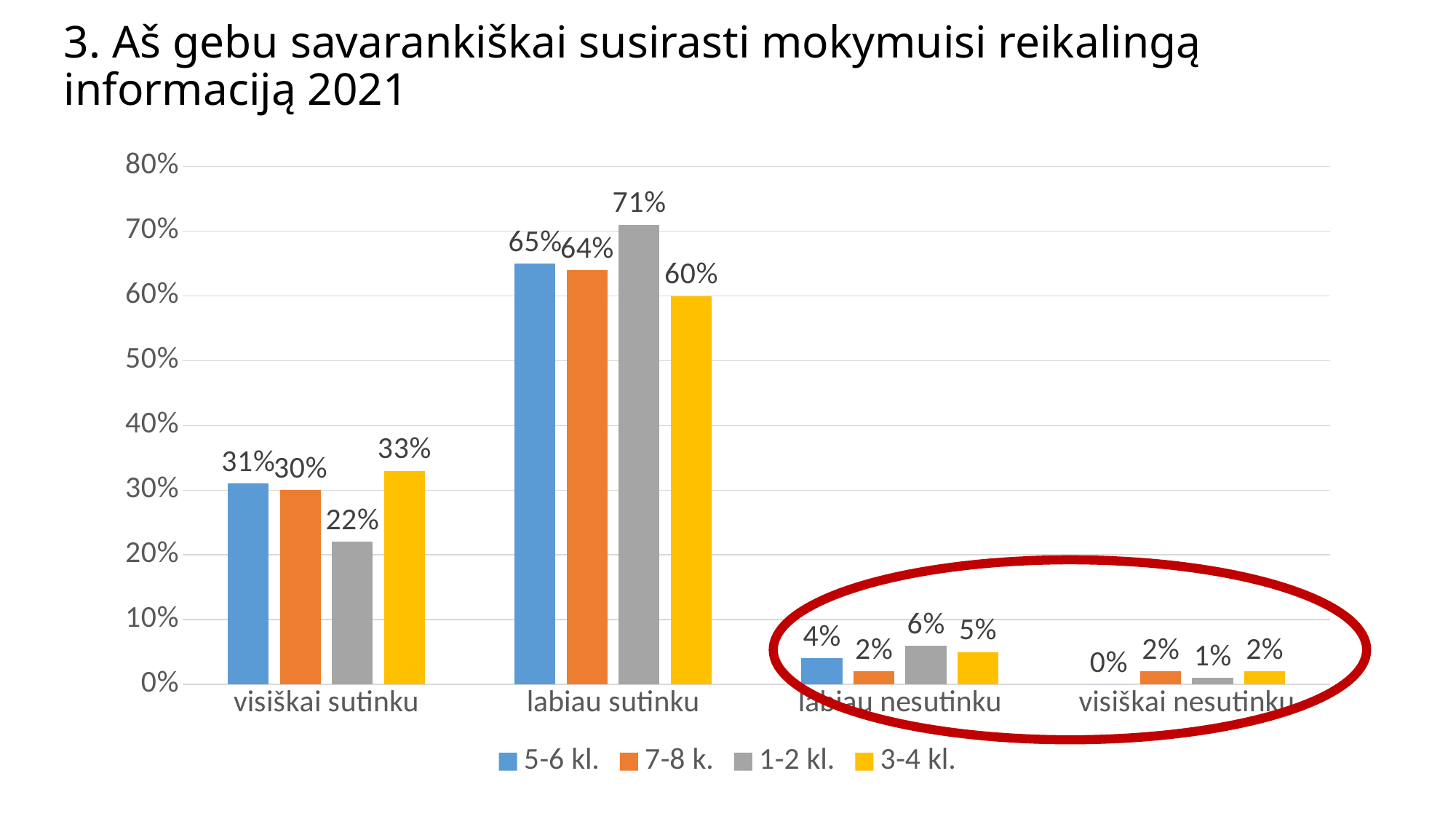
What kind of chart is shown on the slide? Bar chart Which two categories are circled in red on the chart? labiau nesutinku and visiškai nesutinku What is the value for 5-6 kl. in the 'visiškai nesutinku' category? 0% How many categories are shown on the x axis? 4 What is the value for 1-2 kl. in the 'labiau sutinku' category? 71% What is the value for 3-4 kl. in the 'visiškai sutinku' category? 33% How many series does the legend list? 4 Which series has the highest value in the 'labiau sutinku' category? 1-2 kl. What is the difference between the 1-2 kl. and 3-4 kl. values in the 'labiau sutinku' category? 11% Which series has the lowest value in the 'visiškai sutinku' category? 1-2 kl. Which is larger: the 5-6 kl. value for 'visiškai sutinku' or the 7-8 k. value for 'visiškai sutinku'? 5-6 kl. What is the value for 5-6 kl. in the 'labiau nesutinku' category? 4%